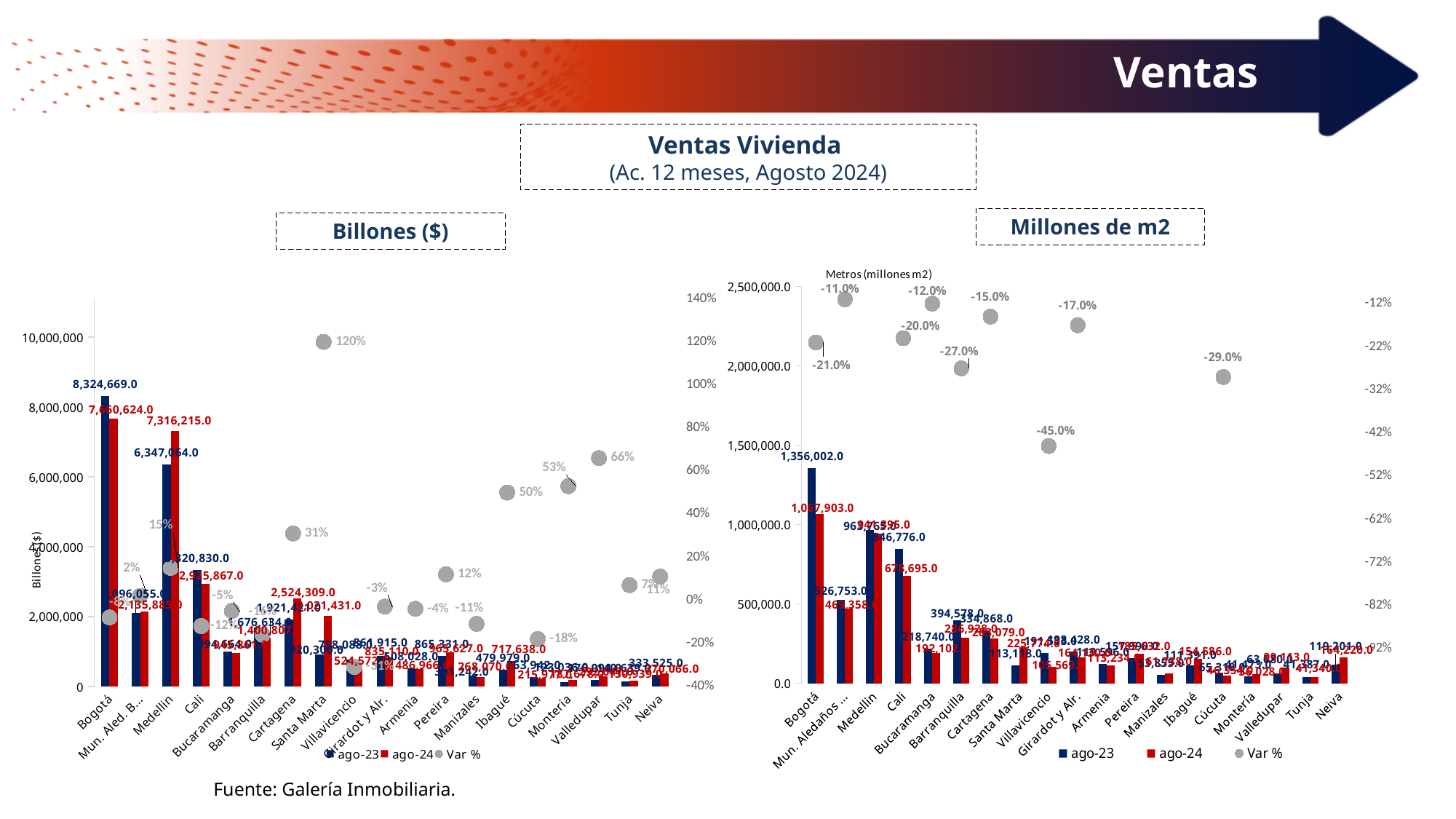
In the Billones ($) chart, what is the ago-24 value for Medellín? 7,316,215.0 In the Billones ($) chart, which city has the highest Var %? Santa Marta How many cities are shown on the x axis of the Billones ($) chart? 19 In the Millones de m2 chart, what is the difference between the ago-23 and ago-24 values for Cali? 168,081.0 In the Billones ($) chart, which is larger for Medellín: the ago-23 value or the ago-24 value? ago-24 In the Millones de m2 chart, what is the ago-23 value for Bogotá? 1,356,002.0 How many series does the legend of the Millones de m2 chart list? 3 In the Billones ($) chart, what is the Var % for Santa Marta? 120% In the Millones de m2 chart, which city has the highest ago-23 value? Bogotá In the Billones ($) chart, what is the difference between the ago-23 and ago-24 values for Bogotá? 664,045.0 In the Billones ($) chart, what is the ago-23 value for Bogotá? 8,324,669.0